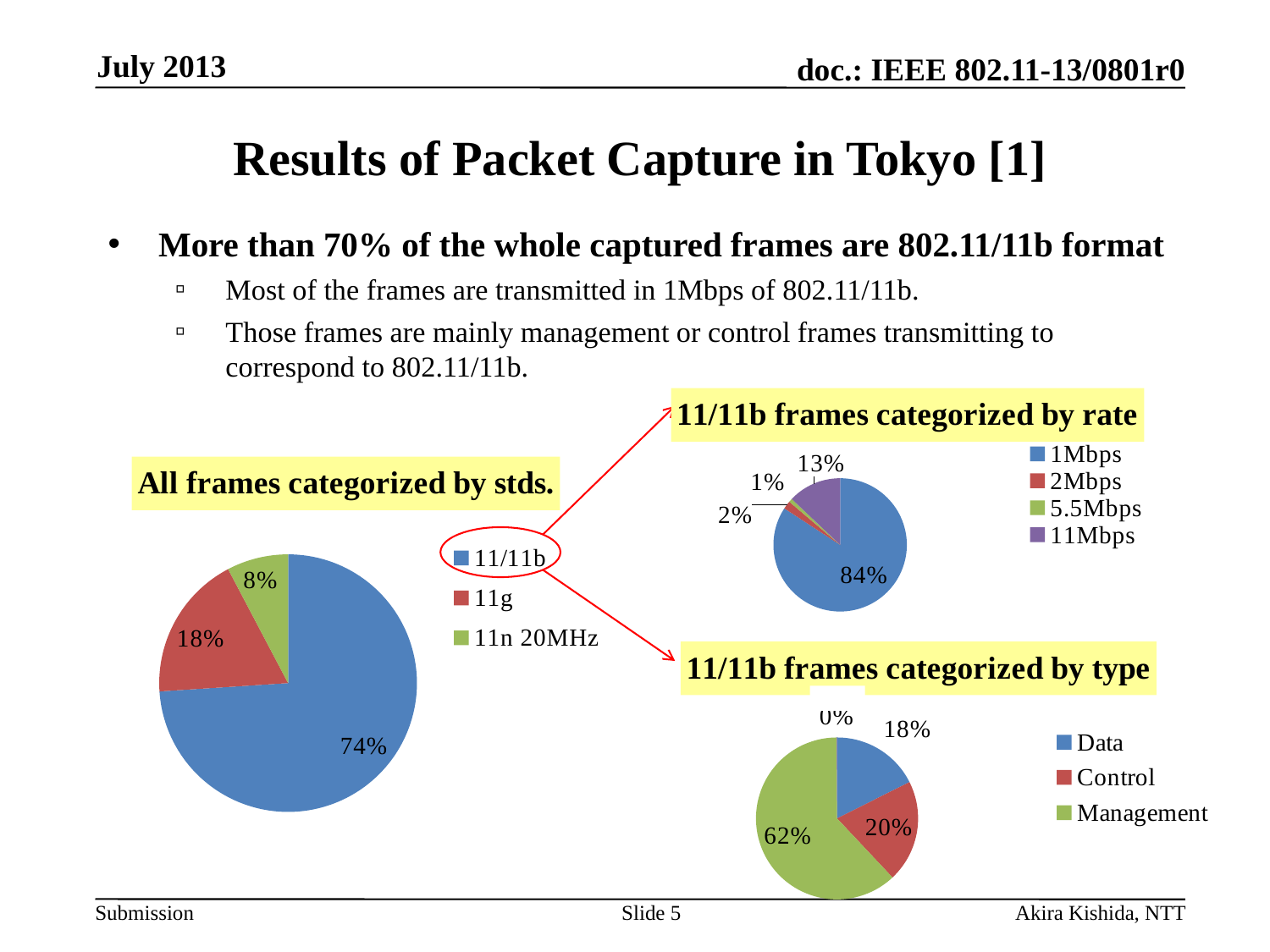
In the 'All frames categorized by stds.' chart, which standard has the smallest share? 11n 20MHz In the 'All frames categorized by stds.' chart, how many categories does the legend list? 3 In the '11/11b frames categorized by rate' chart, what share of frames is 1Mbps? 84% What kind of chart is 'All frames categorized by stds.'? Pie chart In the '11/11b frames categorized by type' chart, what share of frames is Management? 62% In the '11/11b frames categorized by rate' chart, how many rate categories does the legend list? 4 In the '11/11b frames categorized by type' chart, which is larger, Data or Control? Control In the '11/11b frames categorized by rate' chart, which rate has the smallest share? 5.5Mbps In the '11/11b frames categorized by type' chart, what is the difference between the Management share and the Data share? 44% In the '11/11b frames categorized by rate' chart, what share of frames is 11Mbps? 13% In the 'All frames categorized by stds.' chart, what share of frames is 11/11b? 74% In the 'All frames categorized by stds.' chart, what share of frames is 11g? 18%